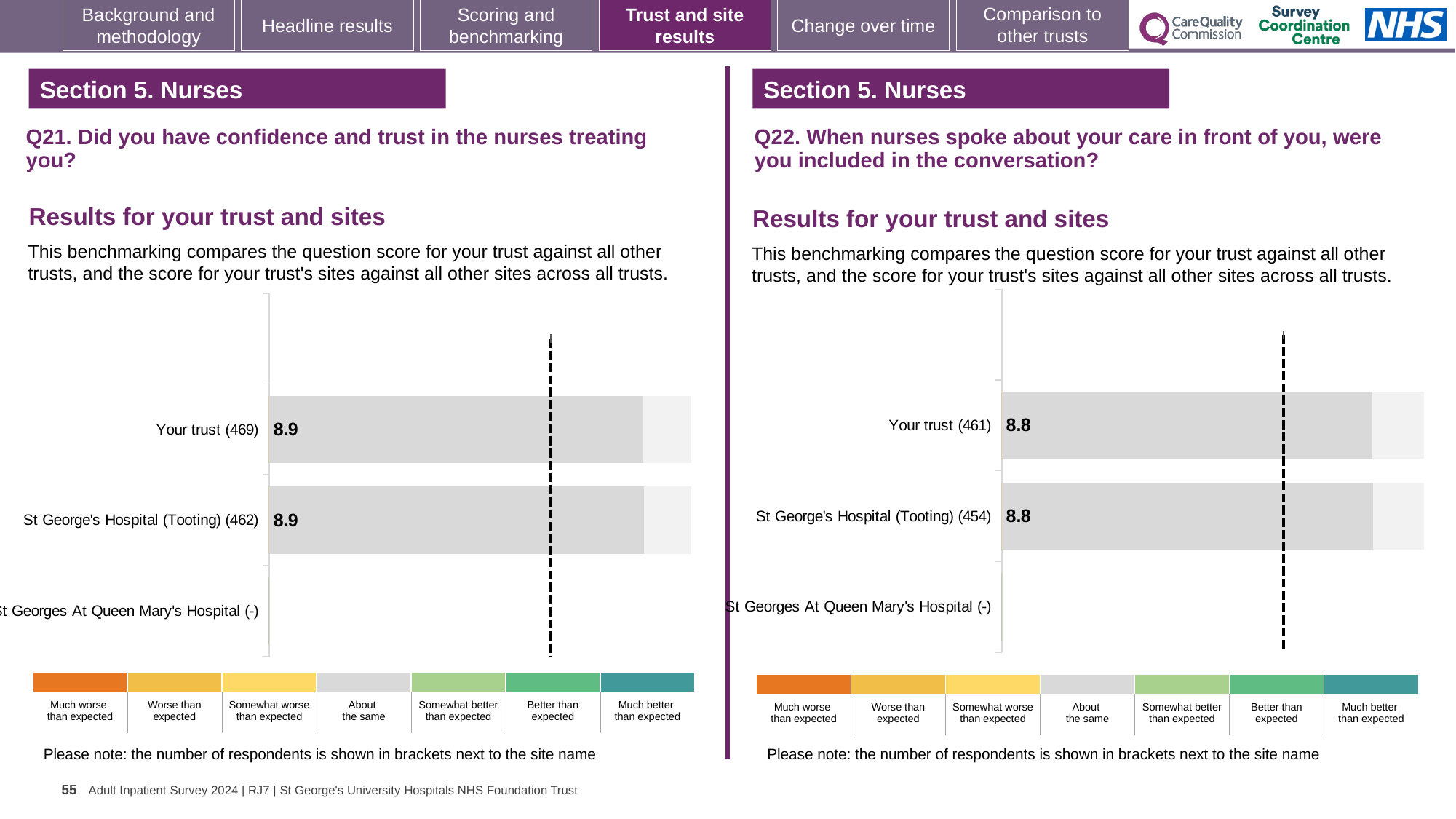
On the Q21 chart (left), what is the difference between the score for Your trust and the score for St George's Hospital (Tooting)? 0.0 How many categories are listed on the Q21 chart (left)? 3 On the Q21 chart (left), which category has no score shown? St Georges At Queen Mary's Hospital (-) On the Q22 chart (right), what is the score for Your trust (461)? 8.8 What kind of chart is the Q21 chart (left)? Bar chart On the Q22 chart (right), how many respondents are shown in brackets for Your trust? 461 Is the score for Your trust on the Q21 chart (left) larger or smaller than the score for Your trust on the Q22 chart (right)? Larger How many categories are listed on the Q22 chart (right)? 3 On the Q21 chart (left), what is the score for Your trust (469)? 8.9 On the Q22 chart (right), what is the difference between the score for Your trust and the score for St George's Hospital (Tooting)? 0.0 On the Q21 chart (left), what is the score for St George's Hospital (Tooting) (462)? 8.9 On the Q22 chart (right), what is the score for St George's Hospital (Tooting) (454)? 8.8